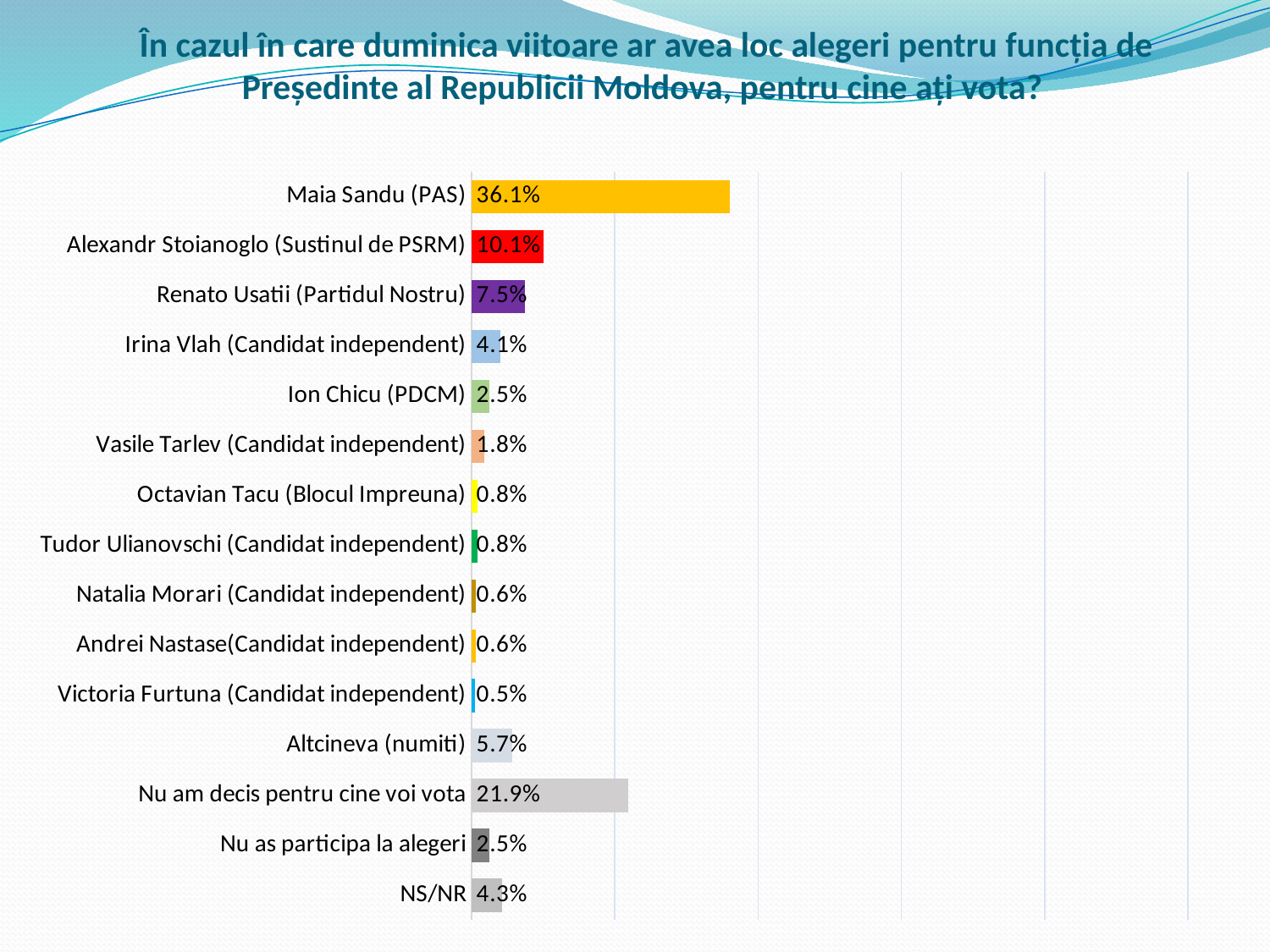
What percentage of respondents would vote for Maia Sandu (PAS)? 36.1% What is the difference between the values for NS/NR and Nu as participa la alegeri? 1.8 percentage points What is the value for Irina Vlah (Candidat independent)? 4.1% Which is larger: the value for Renato Usatii (Partidul Nostru) or the value for Altcineva (numiti)? Renato Usatii (Partidul Nostru) How many categories are shown in the chart? 15 What kind of chart is shown on the slide? Bar chart Which category has the highest value in the chart? Maia Sandu (PAS) What colour is the bar for Maia Sandu (PAS)? Yellow Which category has the lowest value in the chart? Victoria Furtuna (Candidat independent) What is the difference between the values for Maia Sandu (PAS) and Alexandr Stoianoglo (Sustinul de PSRM)? 26.0 percentage points What percentage is shown for 'Nu am decis pentru cine voi vota'? 21.9% What is the value shown for Alexandr Stoianoglo (Sustinul de PSRM)? 10.1%